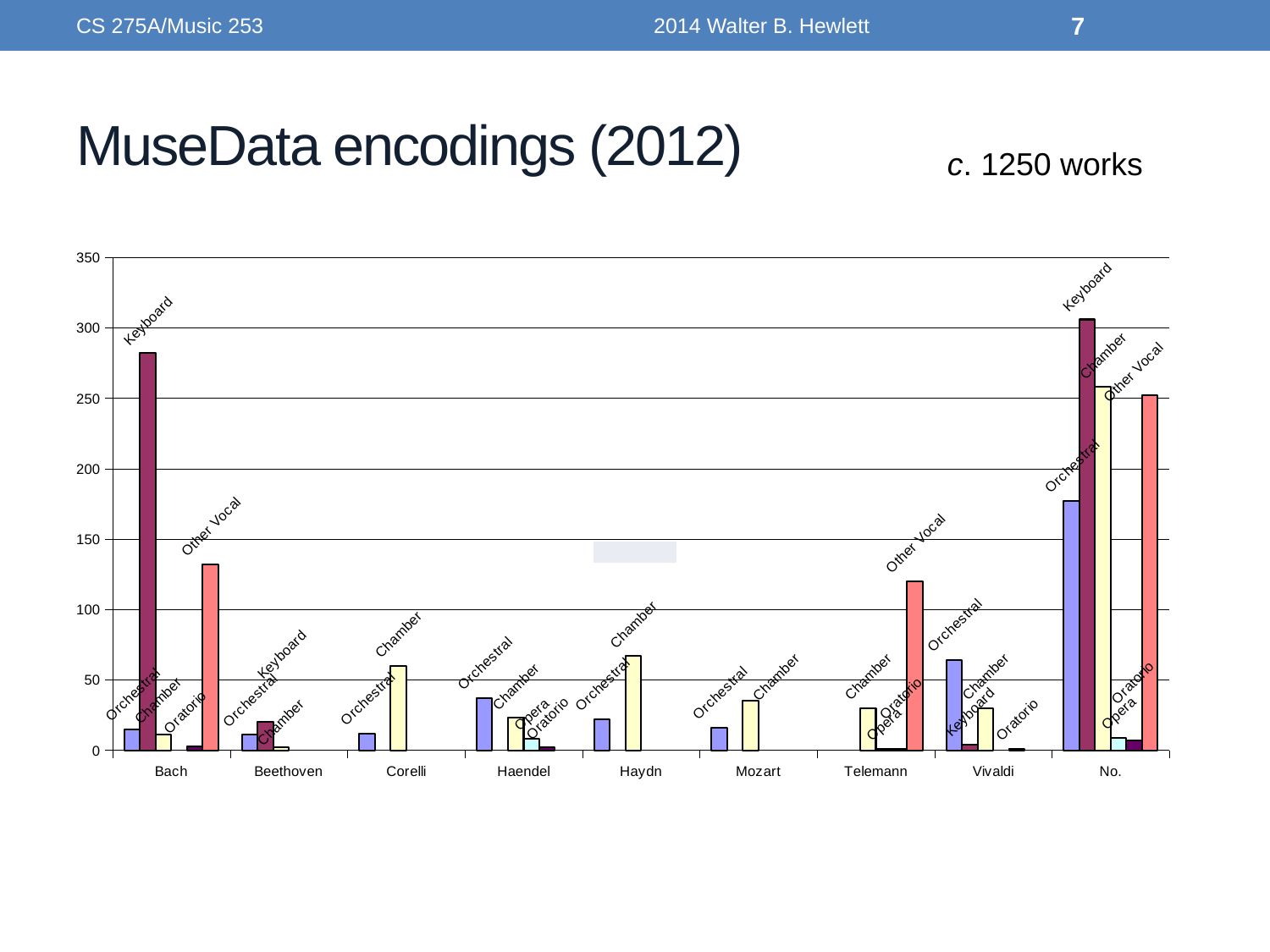
What is the title of the slide containing the chart? MuseData encodings (2012) Is the value for Vivaldi Orchestral greater or less than 50? greater Is the value for Bach Other Vocal greater or less than 100? greater Is the value for Telemann Other Vocal greater or less than 100? greater Which composer group contains the tallest bar in the whole chart? No. Which is larger for Mozart, Orchestral or Chamber? Chamber What kind of chart is shown on the slide? bar chart Which category has the tallest bar in the Bach group? Keyboard Which is larger, Bach Other Vocal or Telemann Other Vocal? Bach Other Vocal How many composer groups are labelled along the x axis of the chart? 9